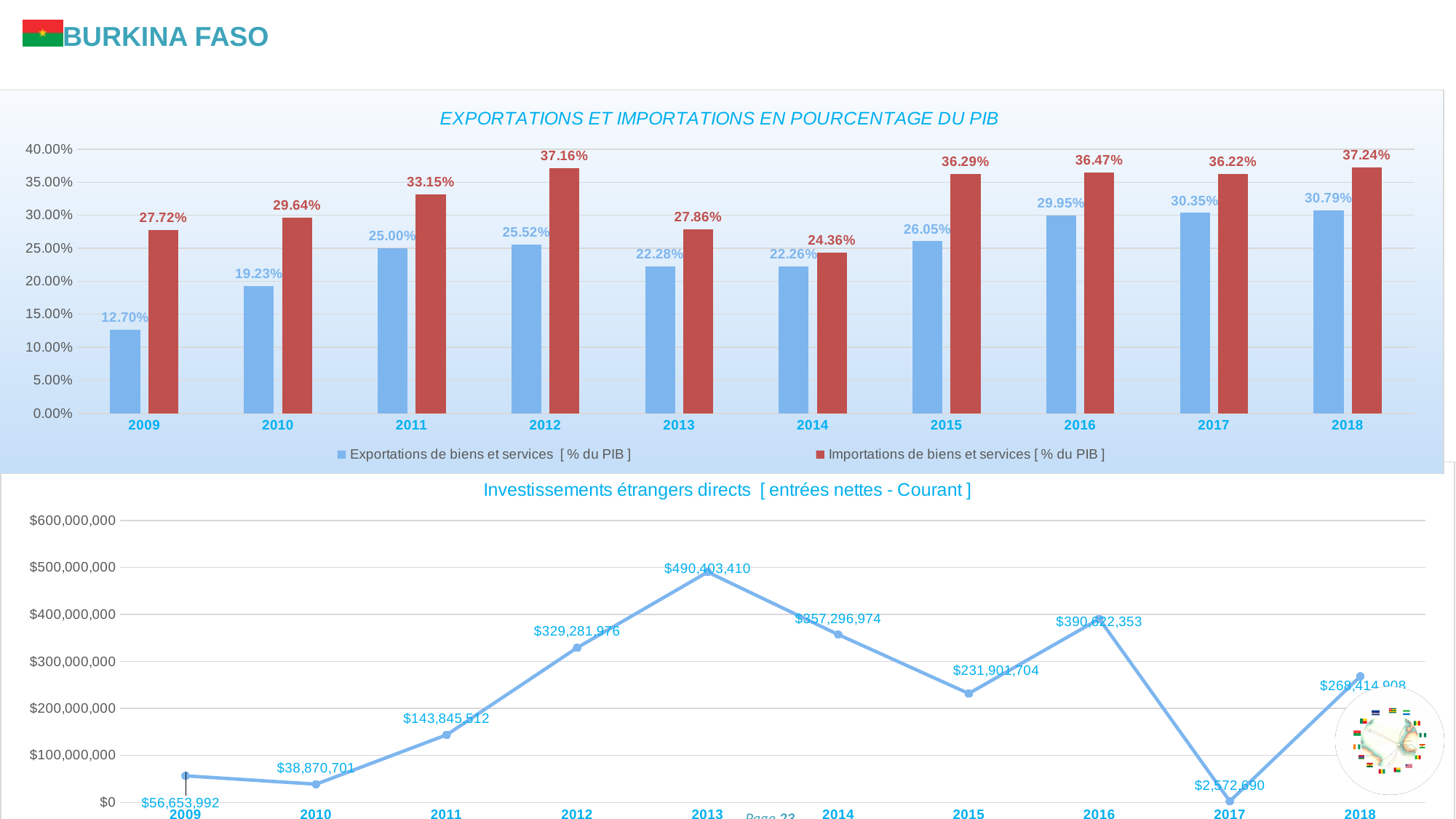
In the chart 'EXPORTATIONS ET IMPORTATIONS EN POURCENTAGE DU PIB', which year has the lowest value for Exportations de biens et services? 2009 In the chart 'EXPORTATIONS ET IMPORTATIONS EN POURCENTAGE DU PIB', what is the value of Exportations de biens et services for 2009? 12.70% In the chart 'Investissements étrangers directs', is the value for 2015 larger or smaller than the value for 2014? smaller In the chart 'EXPORTATIONS ET IMPORTATIONS EN POURCENTAGE DU PIB', which year has the highest value for Importations de biens et services? 2018 In the chart 'Investissements étrangers directs', which year has the highest value? 2013 In the chart 'Investissements étrangers directs', which year has the lowest value? 2017 In the chart 'EXPORTATIONS ET IMPORTATIONS EN POURCENTAGE DU PIB', what is the value of Importations de biens et services for 2012? 37.16% What kind of chart is 'Investissements étrangers directs'? line chart In the chart 'Investissements étrangers directs', what is the value for 2013? $490,403,410 In the chart 'EXPORTATIONS ET IMPORTATIONS EN POURCENTAGE DU PIB', how many years are shown on the x axis? 10 In the chart 'EXPORTATIONS ET IMPORTATIONS EN POURCENTAGE DU PIB', how many series does the legend list? 2 In the chart 'EXPORTATIONS ET IMPORTATIONS EN POURCENTAGE DU PIB', what is the difference between Importations and Exportations in 2014? 2.10%